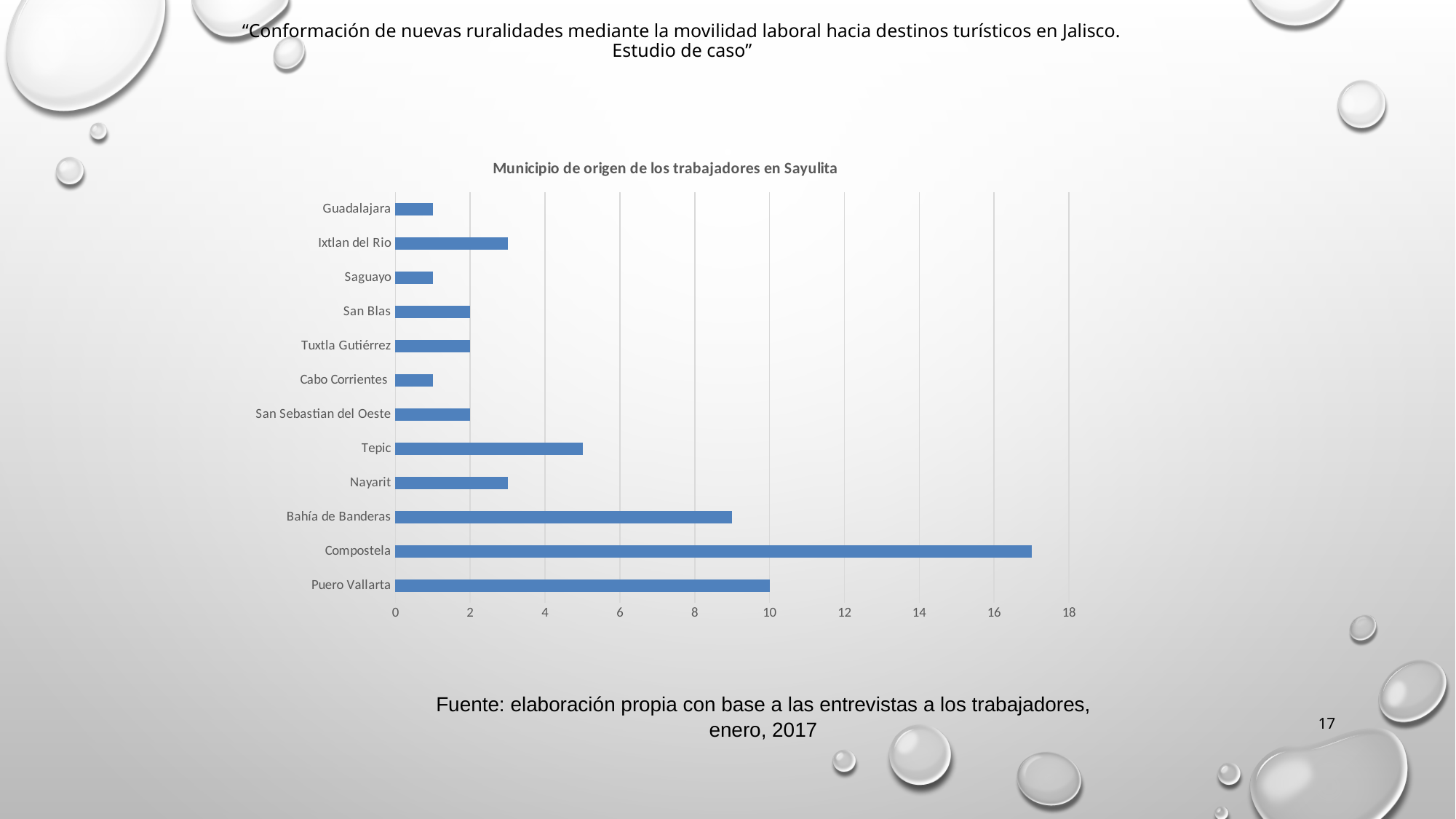
Which municipality has the highest value in the chart? Compostela What is the title of the chart? Municipio de origen de los trabajadores en Sayulita What is the value for Puero Vallarta? 10 What is the value for San Blas? 2 Is the value for Compostela greater or less than 16? greater How many municipalities are listed in the chart? 12 Which has a larger value, Tepic or Nayarit? Tepic What kind of chart is shown on the slide? bar chart Is the value for Bahía de Banderas greater or less than 10? less What is the value for Tuxtla Gutiérrez? 2 What is the difference between the values for Puero Vallarta and San Blas? 8 Is the value for Tepic greater or less than 4? greater